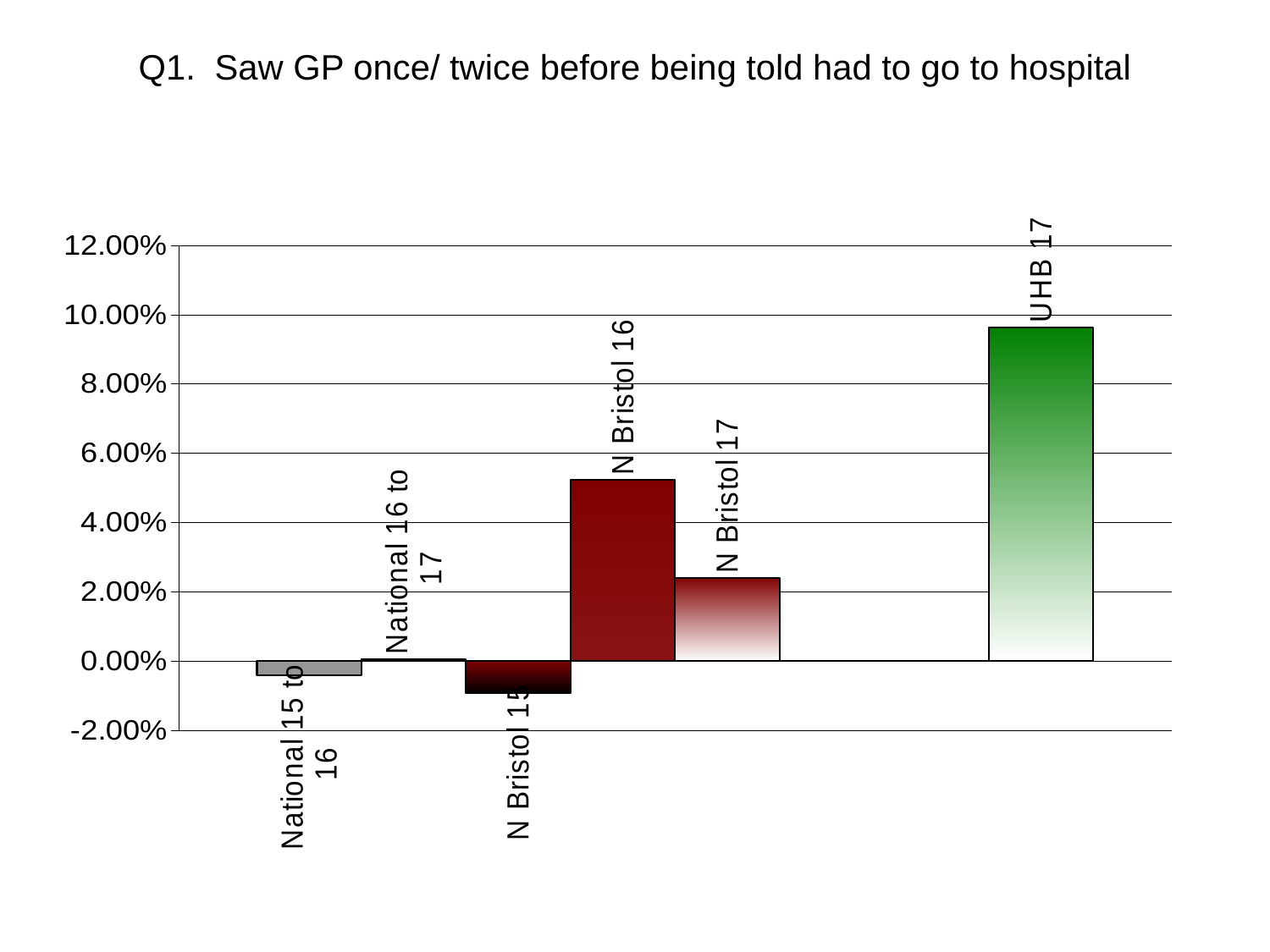
What kind of chart is shown on the slide? bar chart Is the value for N Bristol 16 greater or less than 4.00%? greater What is the title of the chart? Q1. Saw GP once/ twice before being told had to go to hospital Which category has the lowest value? N Bristol 15 Is the value for National 15 to 16 greater or less than 0.00%? less Which category has the highest value? UHB 17 Is the value for N Bristol 17 greater or less than 4.00%? less What colour is the bar for UHB 17? green How many bars are plotted in the chart? 6 Which is larger, the value for N Bristol 16 or the value for N Bristol 17? N Bristol 16 Which is larger, the value for UHB 17 or the value for N Bristol 16? UHB 17